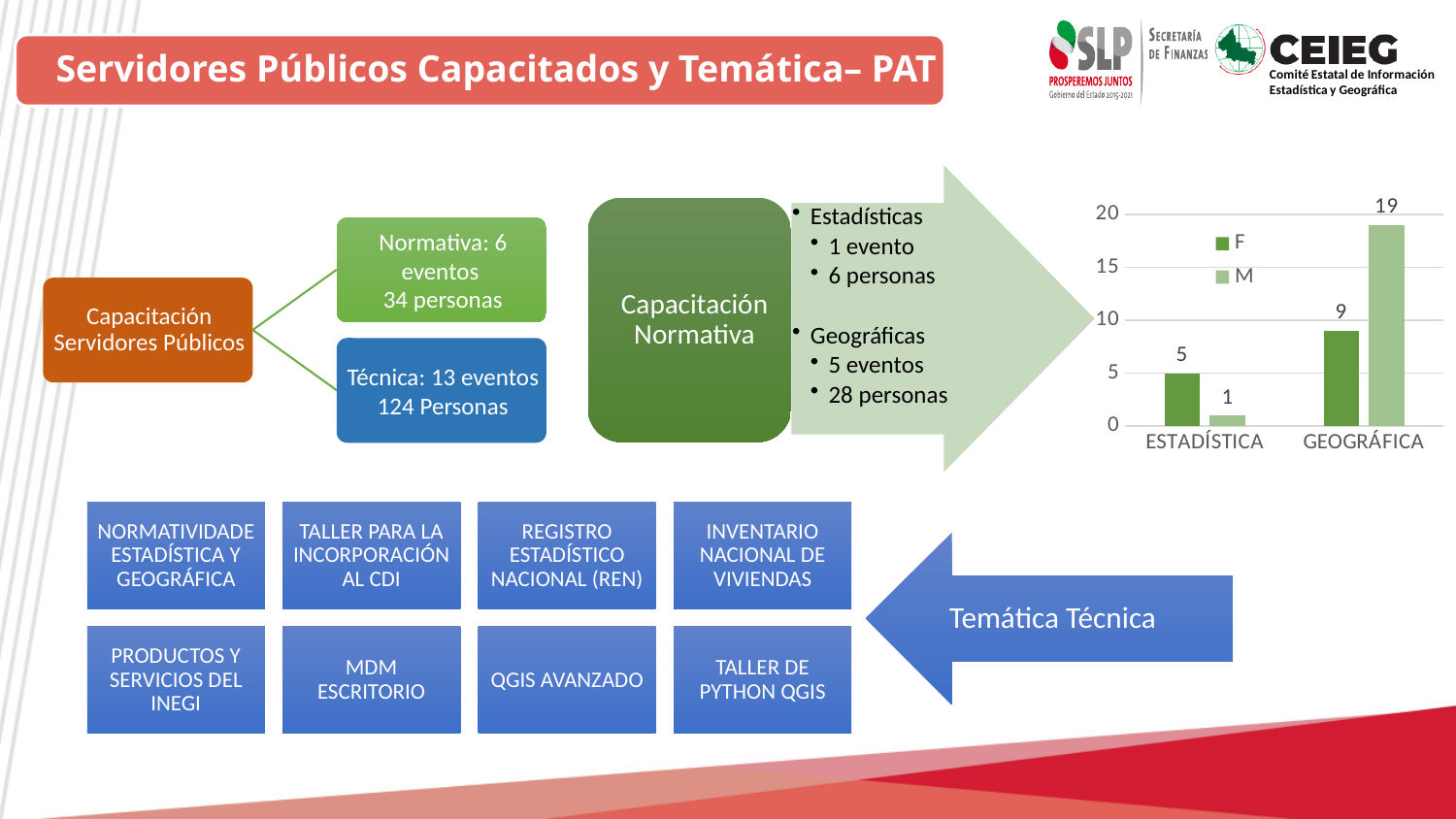
How many series does the chart legend list? 2 What is the value for M in the ESTADÍSTICA category? 1 Which category has the highest M value? GEOGRÁFICA What are the two series names shown in the chart legend? F and M Which is larger in the GEOGRÁFICA category, F or M? M What is the difference between the M values for GEOGRÁFICA and ESTADÍSTICA? 18 How many categories are shown on the x axis of the chart? 2 What is the value for F in the ESTADÍSTICA category? 5 What is the value for F in the GEOGRÁFICA category? 9 Which category has the lowest F value? ESTADÍSTICA What is the value for M in the GEOGRÁFICA category? 19 What kind of chart is shown on the slide? bar chart